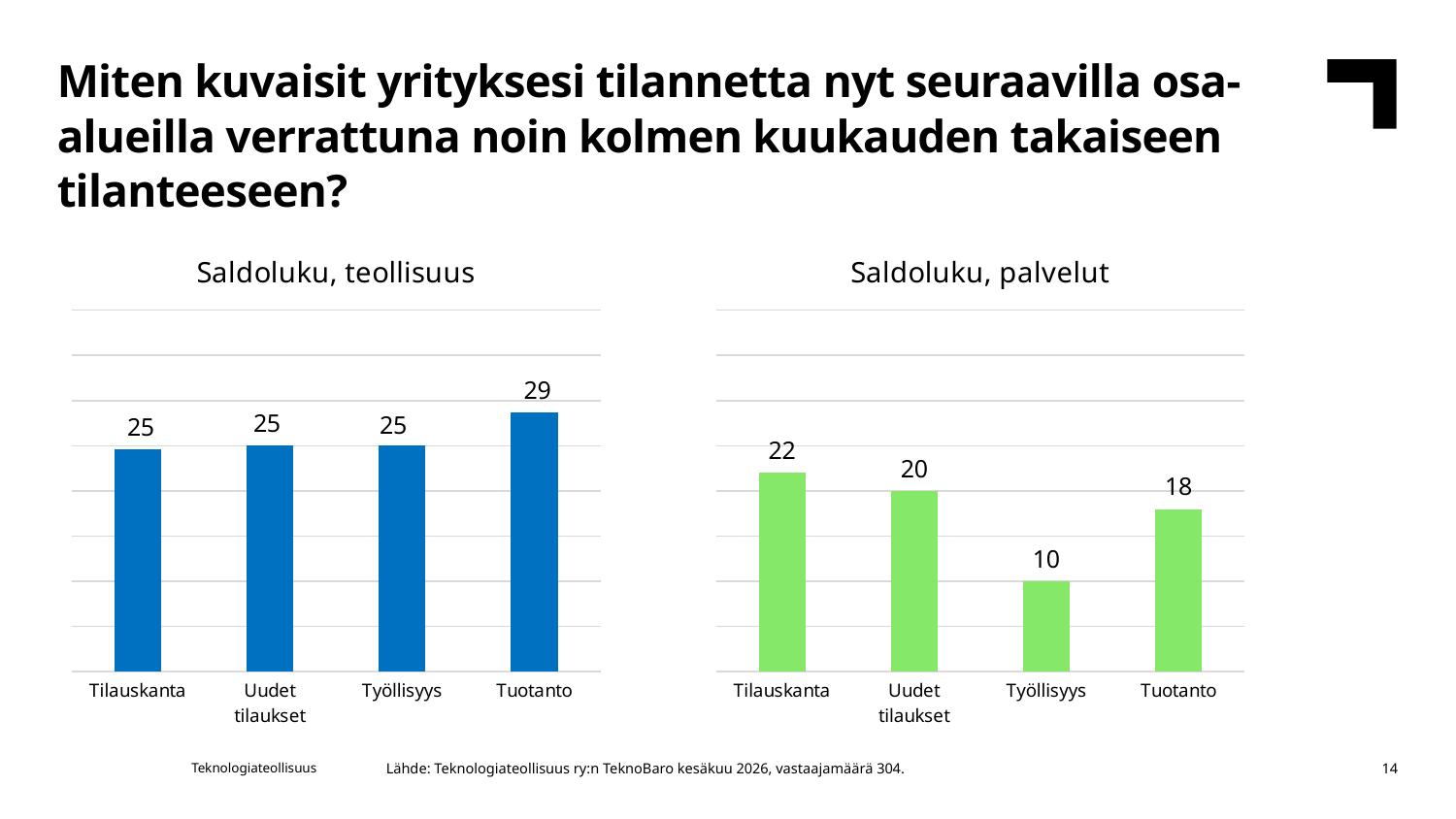
In the 'Saldoluku, palvelut' chart, what is the value for Työllisyys? 10 In the 'Saldoluku, palvelut' chart, which category has the highest value? Tilauskanta Which is larger: the value for Tuotanto in the 'Saldoluku, teollisuus' chart or the value for Tuotanto in the 'Saldoluku, palvelut' chart? Saldoluku, teollisuus In the 'Saldoluku, palvelut' chart, what is the value for Tilauskanta? 22 In the 'Saldoluku, teollisuus' chart, what is the difference between the values for Tuotanto and Tilauskanta? 4 In the 'Saldoluku, palvelut' chart, which category has the lowest value? Työllisyys In the 'Saldoluku, palvelut' chart, what is the difference between the values for Tilauskanta and Työllisyys? 12 In the 'Saldoluku, palvelut' chart, which is larger: Uudet tilaukset or Tuotanto? Uudet tilaukset What kind of chart is the 'Saldoluku, palvelut' chart? Bar chart How many categories are shown in the 'Saldoluku, teollisuus' chart? 4 In the 'Saldoluku, teollisuus' chart, which category has the highest value? Tuotanto In the 'Saldoluku, teollisuus' chart, what is the value for Tuotanto? 29